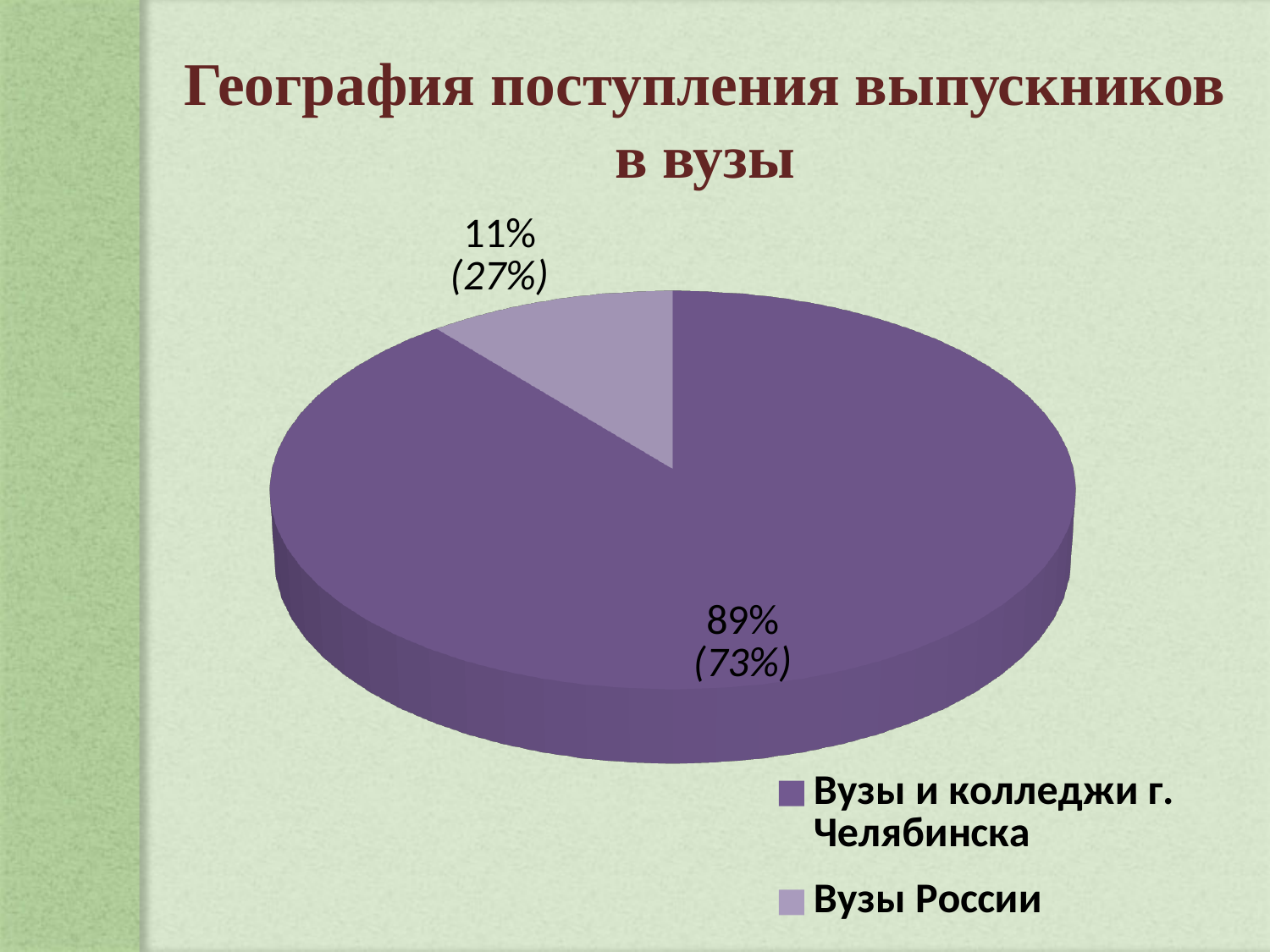
What is the difference in percentage points between the "Вузы и колледжи г. Челябинска" slice (89%) and the "Вузы России" slice (11%)? 78 What is the title of the slide containing the pie chart? География поступления выпускников в вузы How many slices does the pie chart have? 2 How many entries does the legend list? 2 Which slice of the pie is the largest? Вузы и колледжи г. Челябинска What value is shown in parentheses under the 11% label? (27%) What kind of chart is shown on the slide? pie chart What percentage is shown for the slice "Вузы и колледжи г. Челябинска"? 89% What value is shown in parentheses under the 89% label? (73%) Which slice of the pie is the smallest? Вузы России Which is larger: the share for "Вузы России" or the share for "Вузы и колледжи г. Челябинска"? Вузы и колледжи г. Челябинска What percentage is shown for the slice "Вузы России"? 11%